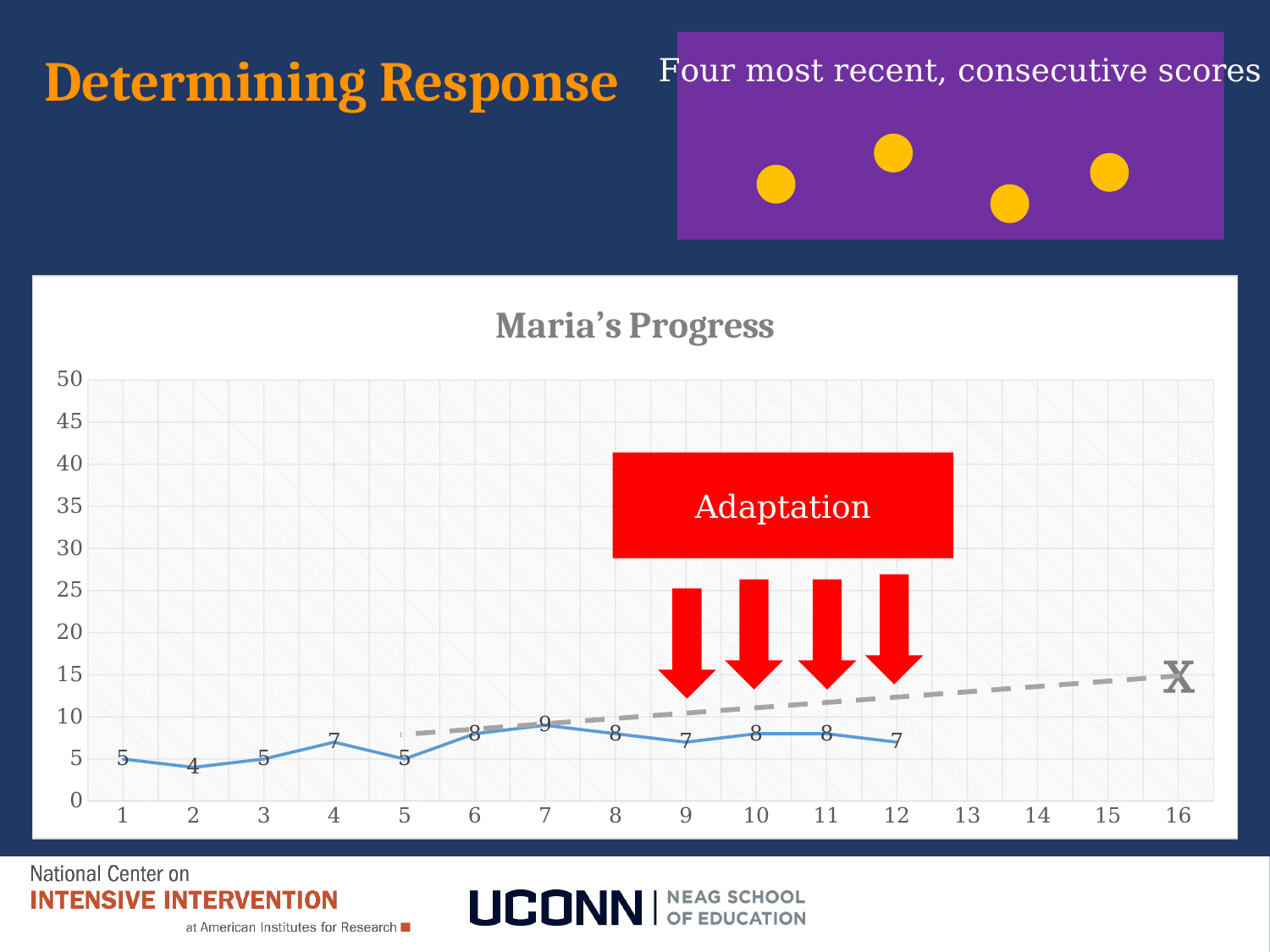
What is the title of the chart? Maria's Progress What is the value plotted at point 2? 4 What is the value plotted at point 7? 9 What is the value plotted at point 12? 7 What is the difference between the value at point 7 and the value at point 2? 5 Is the value at point 10 greater or less than 10? less How many data points are plotted on the line? 12 Which is larger, the value at point 4 or the value at point 5? point 4 What type of chart is shown on the slide? line chart What word appears in the red box above the chart's data? Adaptation At which x-axis point is the plotted value lowest? 2 At which x-axis point is the plotted value highest? 7